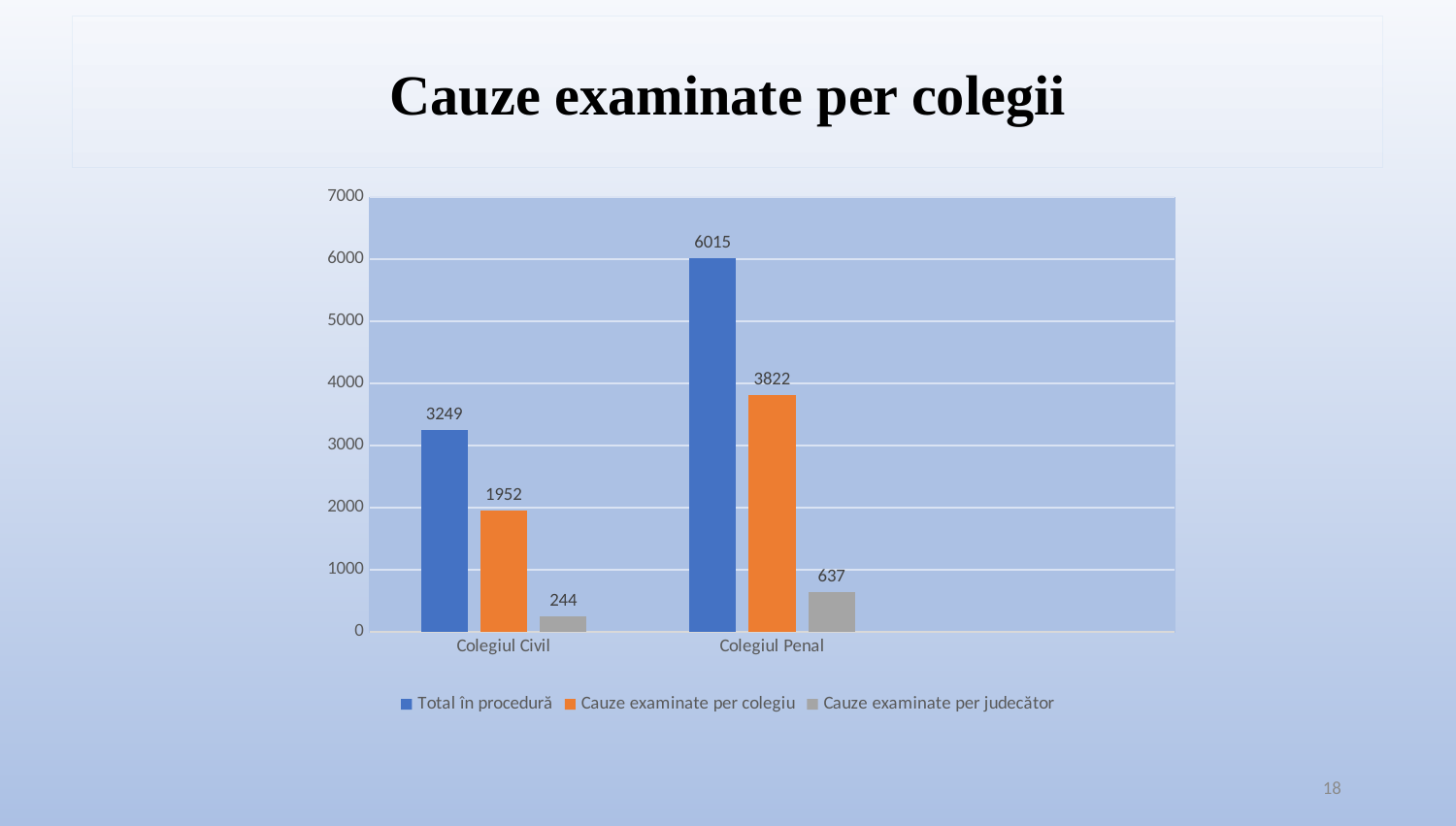
What kind of chart is shown on the slide? Bar chart How many series does the legend list? 3 How many categories are shown on the x axis? 2 What is the value of "Cauze examinate per judecător" for Colegiul Civil? 244 What is the difference between "Total în procedură" for Colegiul Penal and for Colegiul Civil? 2766 What is the value of "Total în procedură" for Colegiul Civil? 3249 What is the value of "Total în procedură" for Colegiul Penal? 6015 What is the difference between "Cauze examinate per judecător" for Colegiul Penal and for Colegiul Civil? 393 Which category has the highest "Total în procedură" value? Colegiul Penal What is the value of "Cauze examinate per colegiu" for Colegiul Penal? 3822 Which series has the lowest value for Colegiul Penal? Cauze examinate per judecător Which is larger: "Cauze examinate per colegiu" for Colegiul Civil or for Colegiul Penal? Colegiul Penal